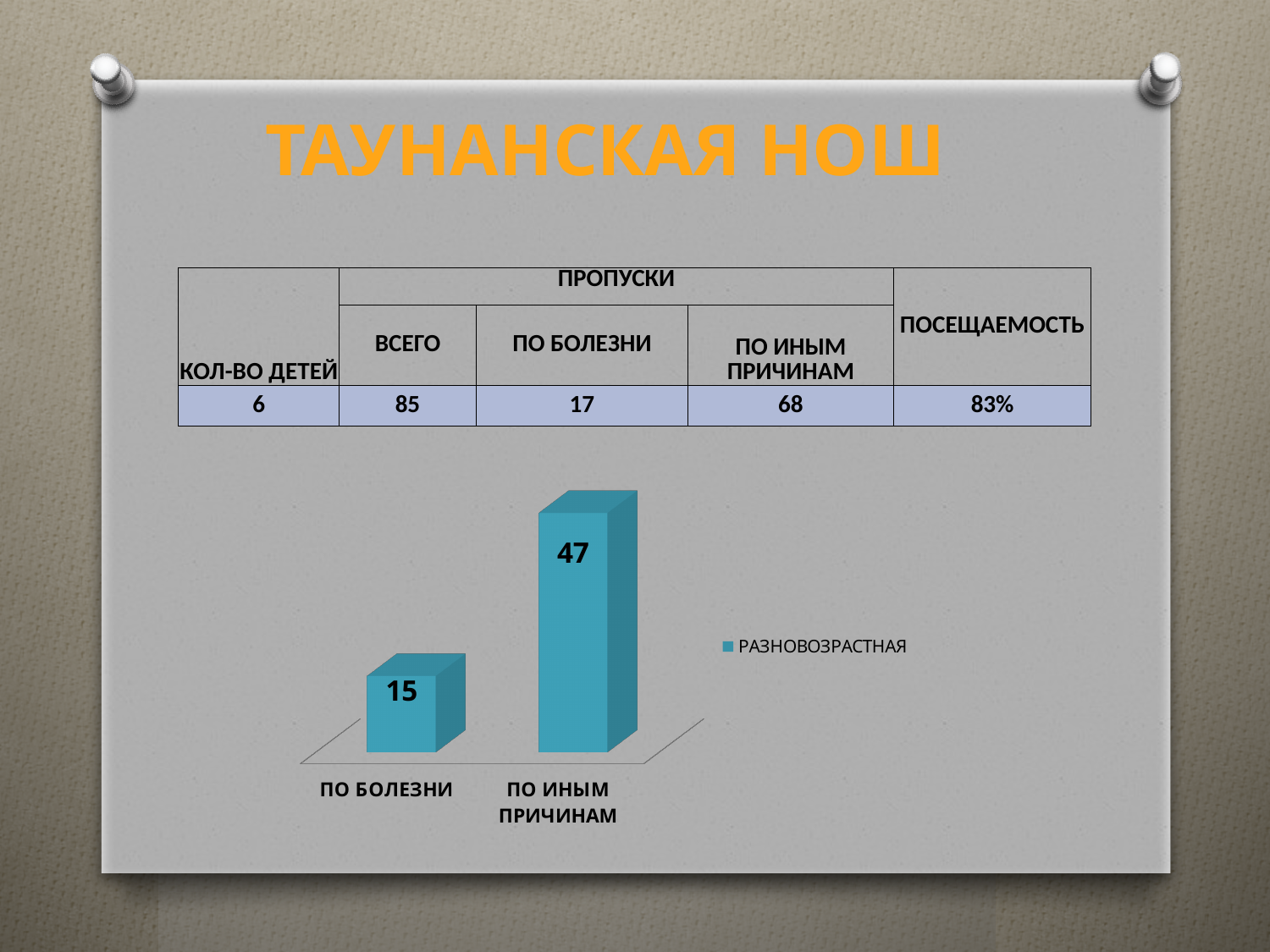
Which is larger in the bar chart: ПО БОЛЕЗНИ or ПО ИНЫМ ПРИЧИНАМ? ПО ИНЫМ ПРИЧИНАМ How many categories are shown in the bar chart? 2 What is the difference between the values for ПО ИНЫМ ПРИЧИНАМ and ПО БОЛЕЗНИ in the bar chart? 32 Which category has the highest value in the bar chart? ПО ИНЫМ ПРИЧИНАМ What is the value for ПО БОЛЕЗНИ in the bar chart? 15 What is the value for ПО ИНЫМ ПРИЧИНАМ in the bar chart? 47 What series name is shown in the legend of the bar chart? РАЗНОВОЗРАСТНАЯ What is the total of the two values shown in the bar chart? 62 What kind of chart is shown on the slide? bar chart Which category has the lowest value in the bar chart? ПО БОЛЕЗНИ What is the title of the slide containing the bar chart? ТАУНАНСКАЯ НОШ How many series does the legend of the bar chart list? 1